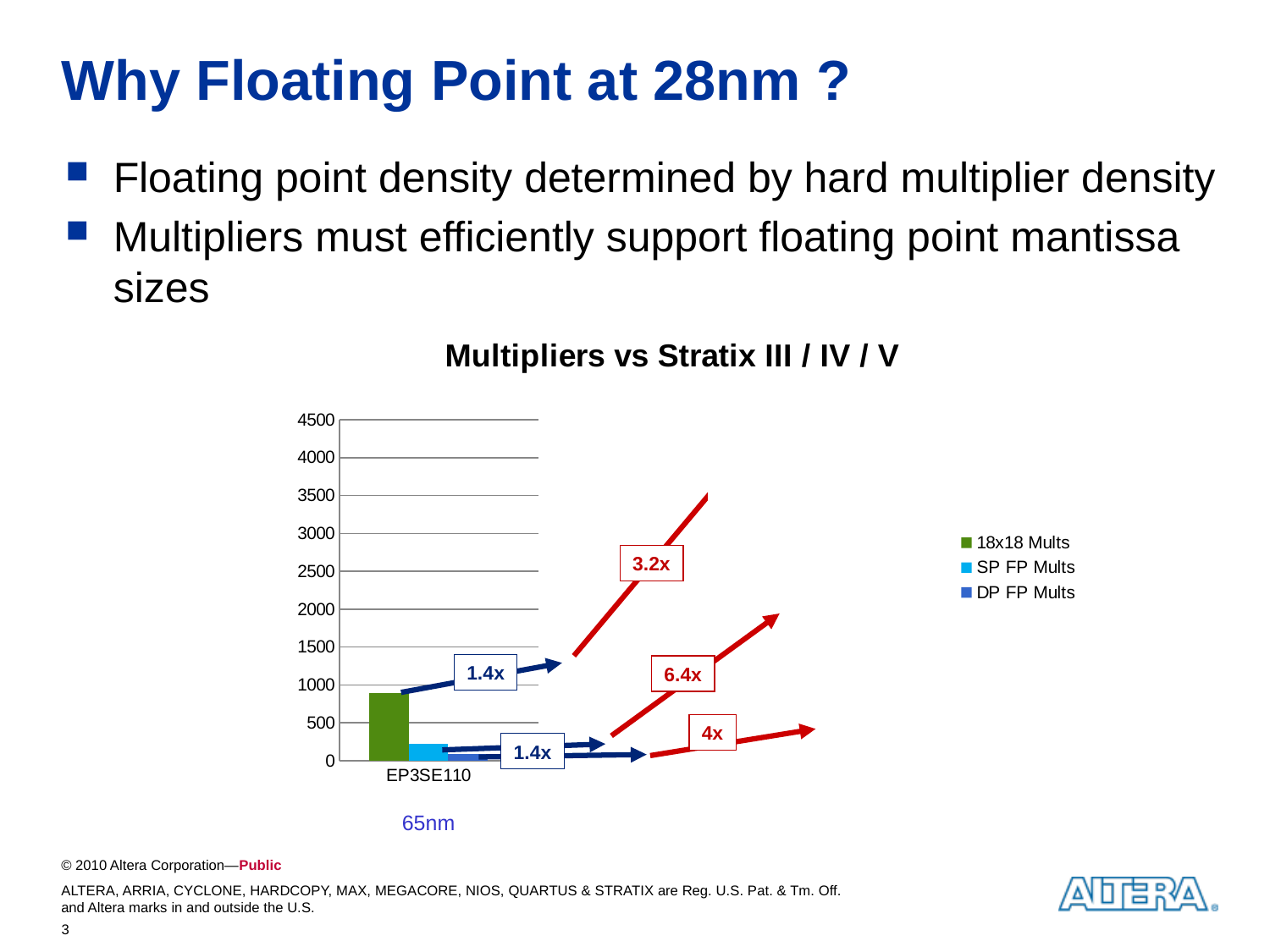
Which series is shown in green in the chart legend? 18x18 Mults How many categories are shown on the x axis of the chart? 1 How many series does the chart legend list? 3 Which series has the lowest value for EP3SE110? DP FP Mults Is the value for SP FP Mults at EP3SE110 greater or less than 500? less Which series has the highest value for EP3SE110? 18x18 Mults Is the value for 18x18 Mults at EP3SE110 greater or less than 500? greater Which is larger for EP3SE110, SP FP Mults or DP FP Mults? SP FP Mults What kind of chart is shown on the slide? bar chart What is the title of the chart? Multipliers vs Stratix III / IV / V Which is larger for EP3SE110, 18x18 Mults or SP FP Mults? 18x18 Mults Is the value for 18x18 Mults at EP3SE110 greater or less than 1000? less